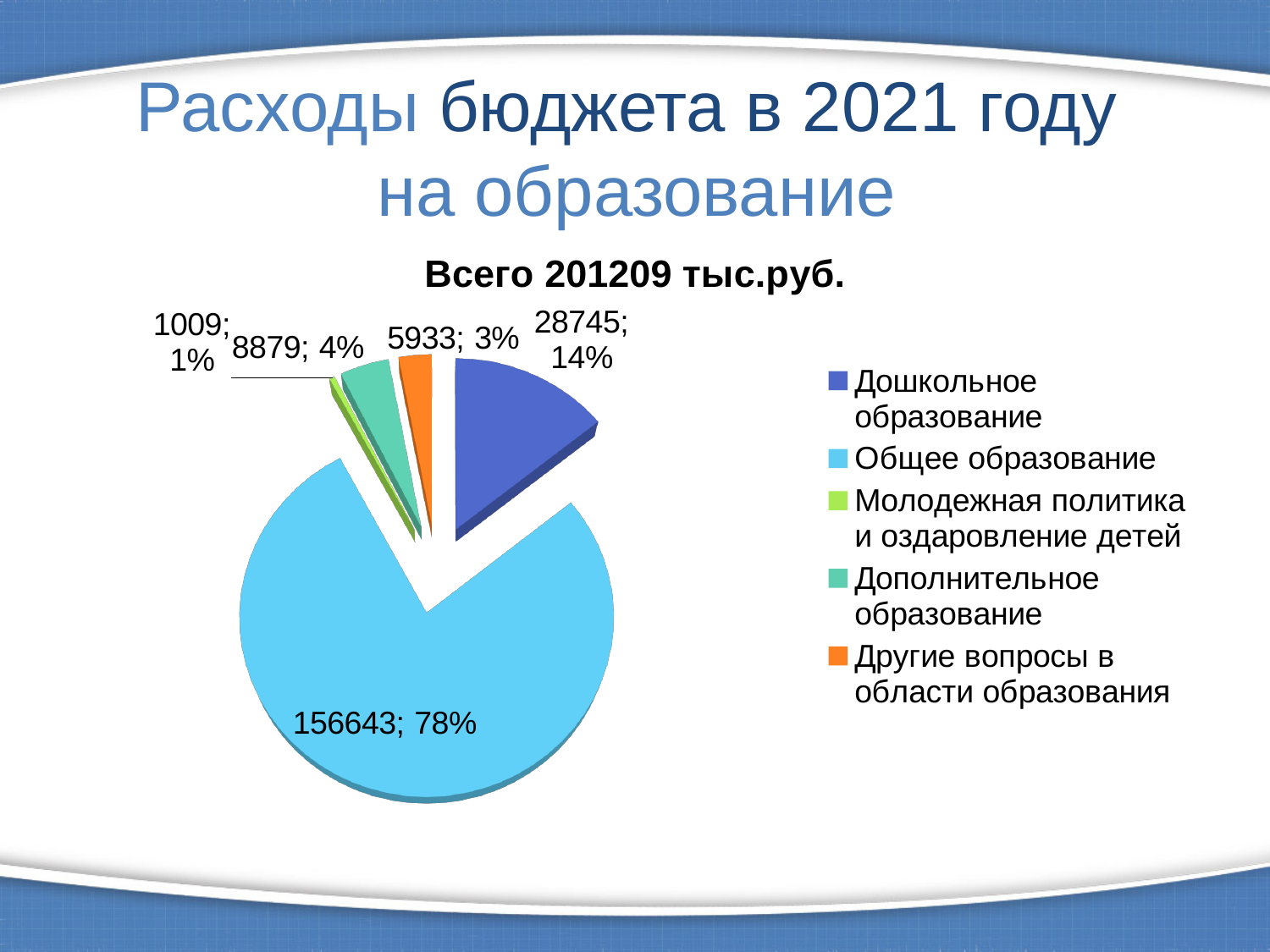
What value is shown for Дошкольное образование? 28745 What value is shown for Дополнительное образование? 8879 What value is shown for Другие вопросы в области образования? 5933 What kind of chart is shown on the slide? Pie chart What is the title of the chart? Всего 201209 тыс.руб. What share of the pie does Молодежная политика и оздаровление детей take? 1% Which category has the smallest slice of the pie? Молодежная политика и оздаровление детей How many entries does the chart legend list? 5 Which category has the largest slice of the pie? Общее образование What value is shown for Общее образование? 156643 What is the difference between the values for Дошкольное образование and Дополнительное образование? 19866 What share of the pie does Общее образование take? 78%